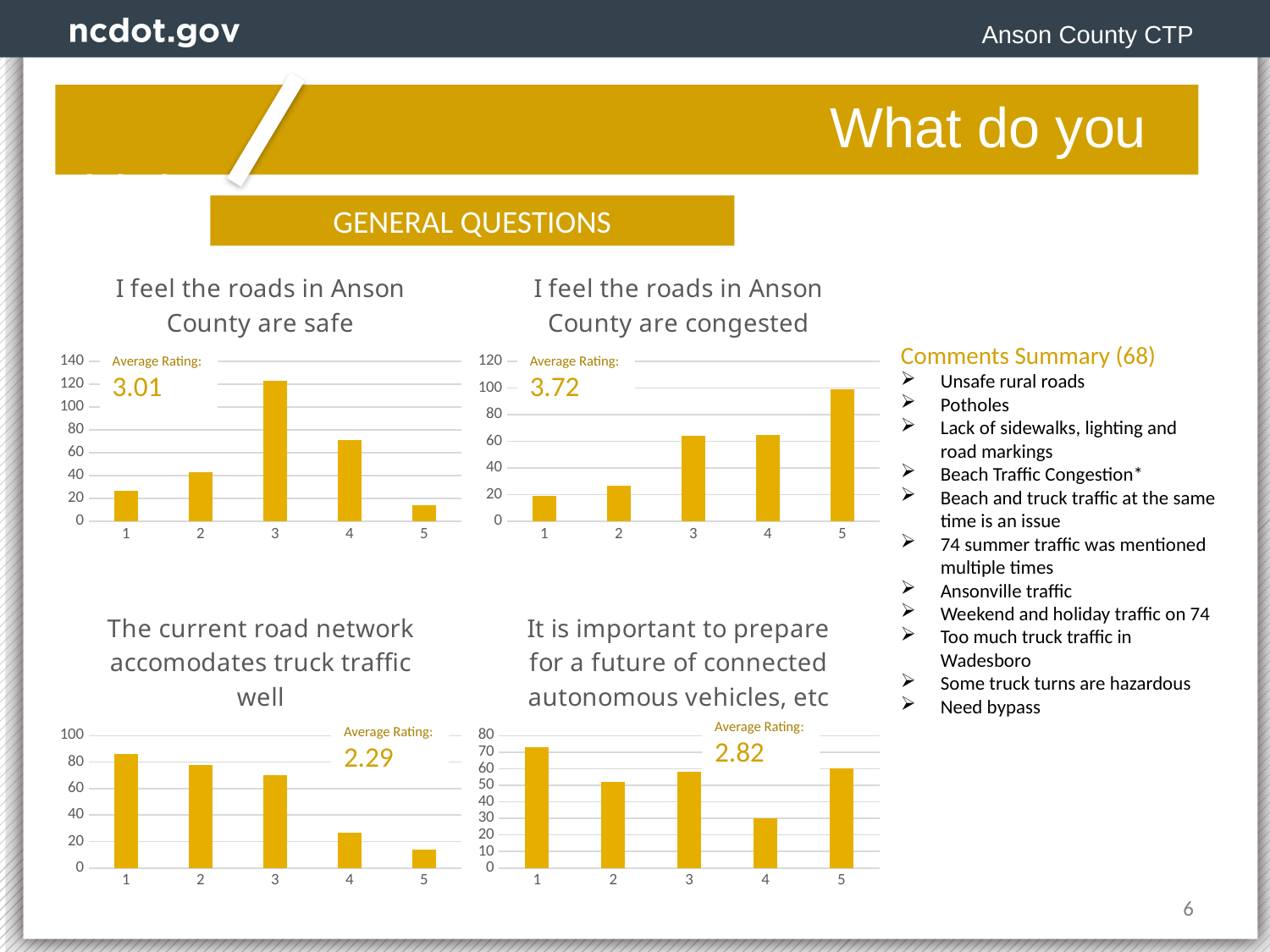
In the chart titled "I feel the roads in Anson County are congested", which rating category has the highest bar? 5 In the chart titled "I feel the roads in Anson County are safe", which rating category has the highest bar? 3 In the chart titled "I feel the roads in Anson County are congested", which is larger, the value for rating 2 or the value for rating 5? 5 In the chart titled "The current road network accomodates truck traffic well", do the values rise or fall as the rating goes from 1 to 5? fall In the chart titled "It is important to prepare for a future of connected autonomous vehicles, etc", which rating category has the highest bar? 1 In the chart titled "The current road network accomodates truck traffic well", is the value for rating 1 greater or less than 80? greater In the chart titled "I feel the roads in Anson County are safe", which rating category has the lowest bar? 5 How many rating categories are shown on the x axis of the chart titled "I feel the roads in Anson County are safe"? 5 In the chart titled "I feel the roads in Anson County are safe", is the value for rating 3 greater or less than 120? greater What type of chart is used for "I feel the roads in Anson County are congested"? bar chart In the chart titled "It is important to prepare for a future of connected autonomous vehicles, etc", which rating category has the lowest bar? 4